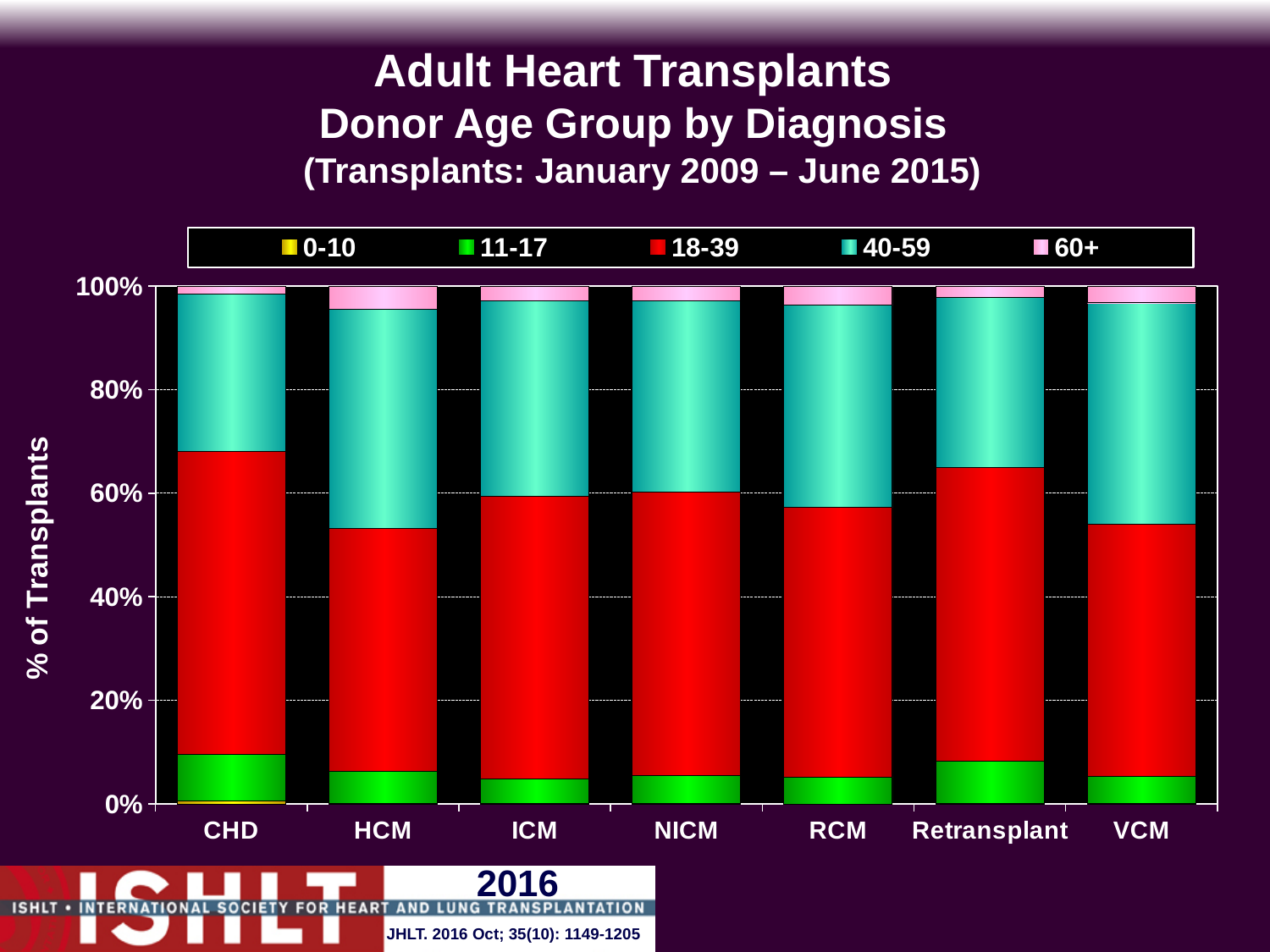
What is the label on the y axis? % of Transplants Which has the larger 18-39 donor age segment, CHD or VCM? CHD What does each stacked bar total? 100% Which has the larger 40-59 donor age segment, VCM or CHD? VCM Is the combined share of donors aged 0-39 for CHD greater or less than 60%? greater Which diagnosis category has the smallest 60+ donor age segment? CHD Is the 11-17 donor age segment for CHD greater or less than 20%? less How many diagnosis categories are shown on the x axis? 7 What kind of chart is shown on the slide? Stacked bar chart How many donor age groups does the legend list? 5 Is the combined share of donors aged 0-39 for VCM greater or less than 60%? less Which diagnosis category has the largest 60+ donor age segment? HCM